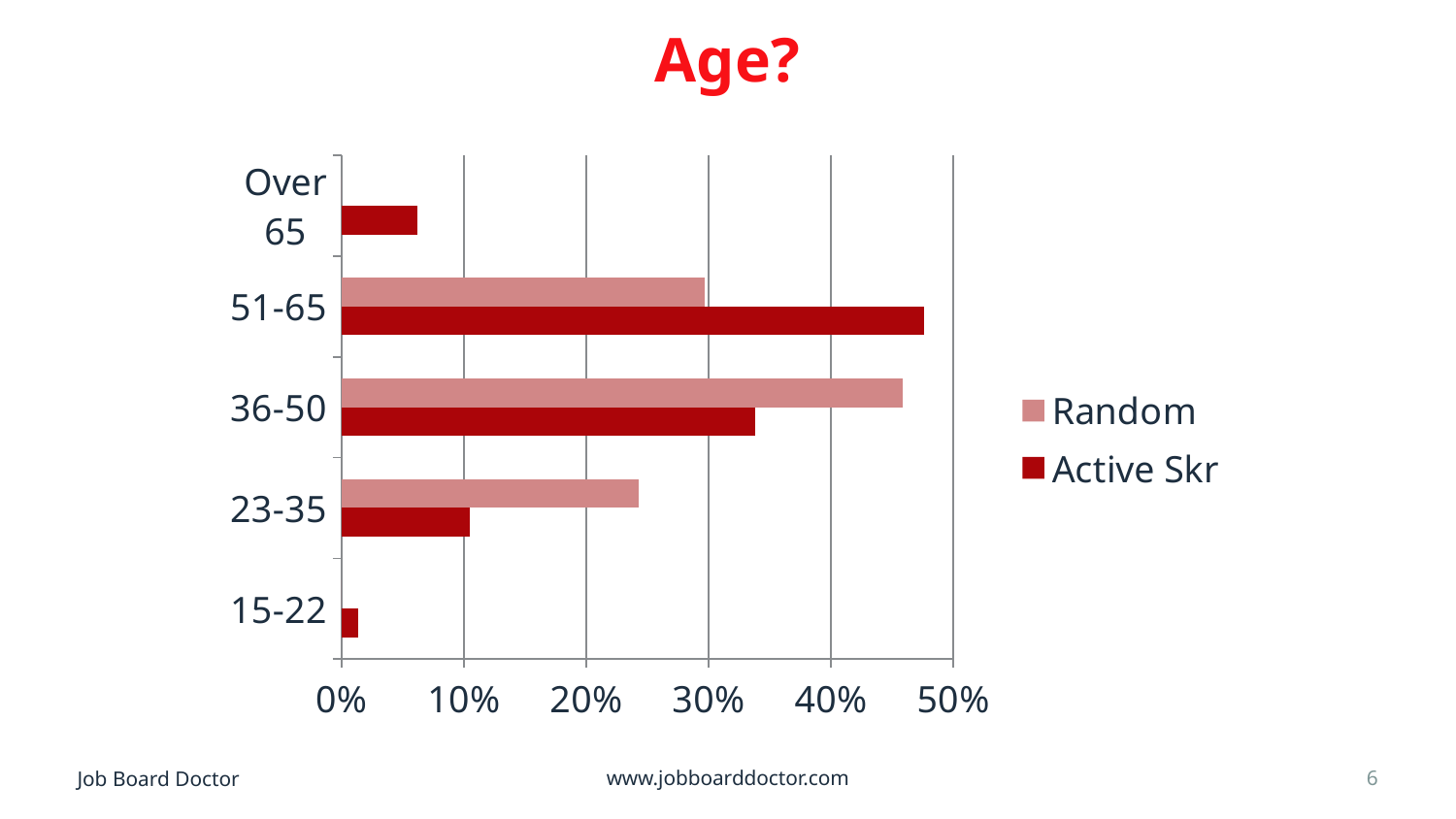
Which age category has the highest value for the Random series? 36-50 How many series does the legend list? 2 What is the title of the chart? Age? Which age category has the highest value for the Active Skr series? 51-65 Is the Active Skr value for 51-65 greater or less than 40%? greater Is the Random value for 36-50 greater or less than 40%? greater Which age category has the lowest value for the Active Skr series? 15-22 For the 51-65 category, which series has the larger value, Random or Active Skr? Active Skr For the 36-50 category, which series has the larger value, Random or Active Skr? Random What kind of chart is shown on the slide? Bar chart Is the Active Skr value for 23-35 greater or less than 20%? less How many age categories are shown on the chart? 5